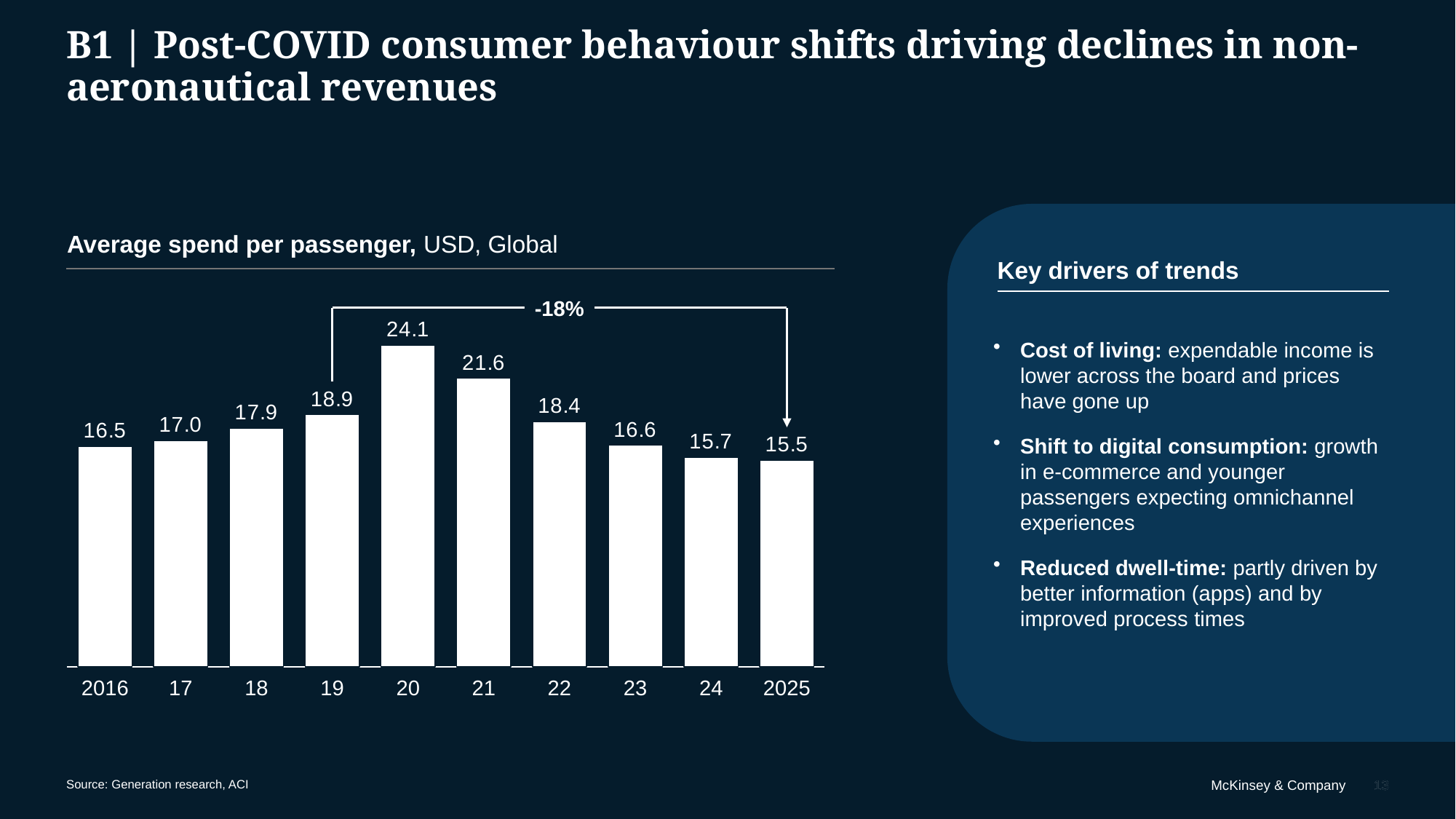
Which year has a higher average spend per passenger, 2018 or 2022? 2022 What is the average spend per passenger in 2020? 24.1 What is the average spend per passenger in 2025? 15.5 What is the difference in average spend per passenger between 2020 and 2021? 2.5 What is the average spend per passenger in 2016? 16.5 How does the average spend per passenger change from 2020 to 2025? It falls Which year has the highest average spend per passenger? 2020 What is the difference in average spend per passenger between 2019 and 2025? 3.4 What kind of chart is used to show average spend per passenger? Bar chart How many years are shown in the chart? 10 Which year has the lowest average spend per passenger? 2025 What percentage change is annotated between 2019 and 2025 on the chart? -18%